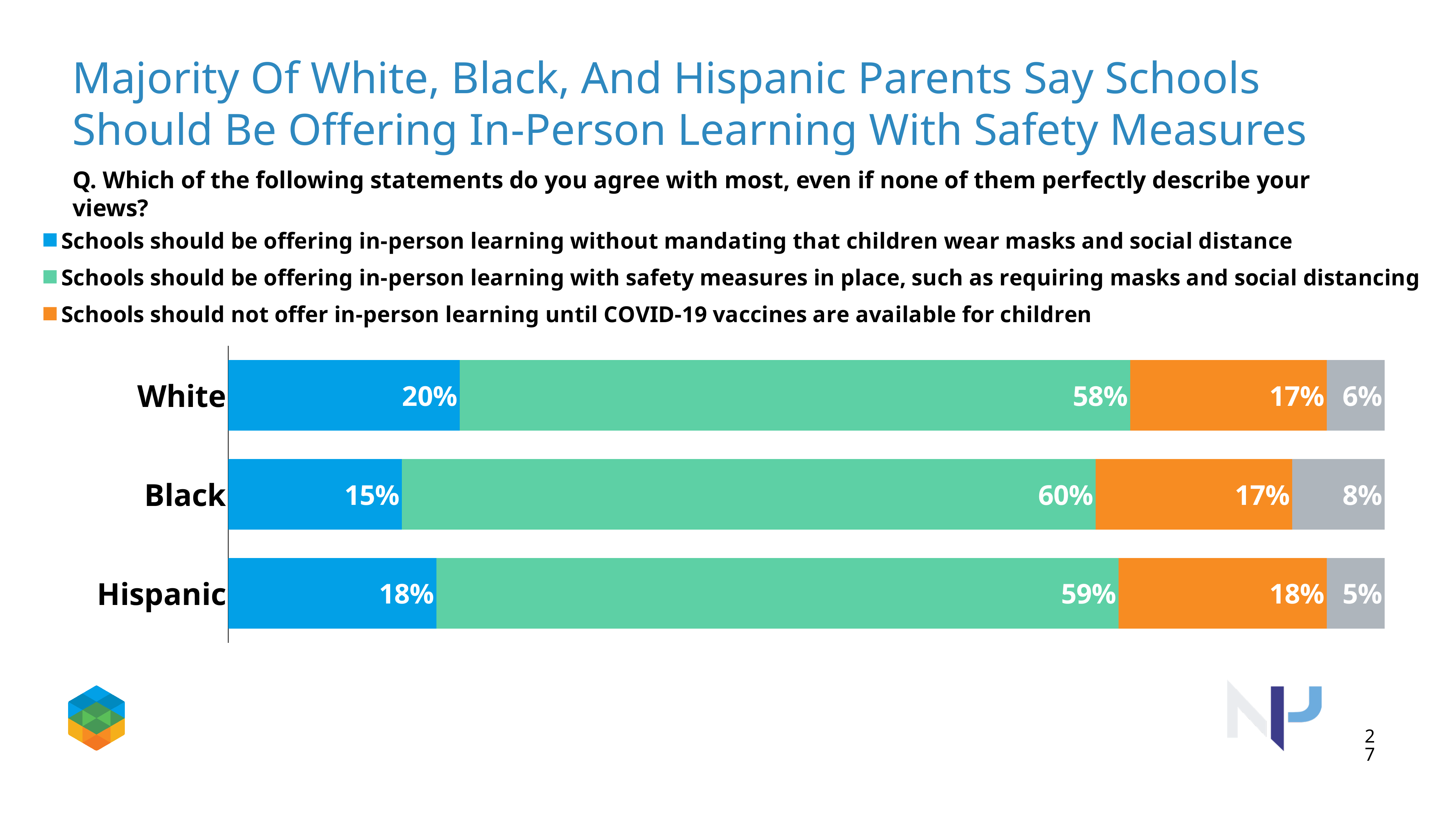
Which colour represents the statement that schools should not offer in-person learning until COVID-19 vaccines are available for children? Orange What percentage of Black parents say schools should be offering in-person learning with safety measures in place? 60% What is the difference between the share of White parents and Black parents who say schools should be offering in-person learning without mandating masks and social distancing? 5 percentage points How many statements does the legend list? 3 How many groups of parents are shown in the chart? 3 What is the combined share of Hispanic parents who say schools should be offering in-person learning, either without mandates or with safety measures? 77% Which group has the lowest share saying schools should be offering in-person learning without mandating masks and social distancing? Black What kind of chart is shown on the slide? Stacked bar chart What percentage of White parents say schools should be offering in-person learning without mandating that children wear masks and social distance? 20% Which is larger: the share of Black parents or Hispanic parents who say schools should be offering in-person learning with safety measures in place? Black Which group has the highest share saying schools should be offering in-person learning without mandating masks and social distancing? White What percentage of Hispanic parents say schools should not offer in-person learning until COVID-19 vaccines are available for children? 18%